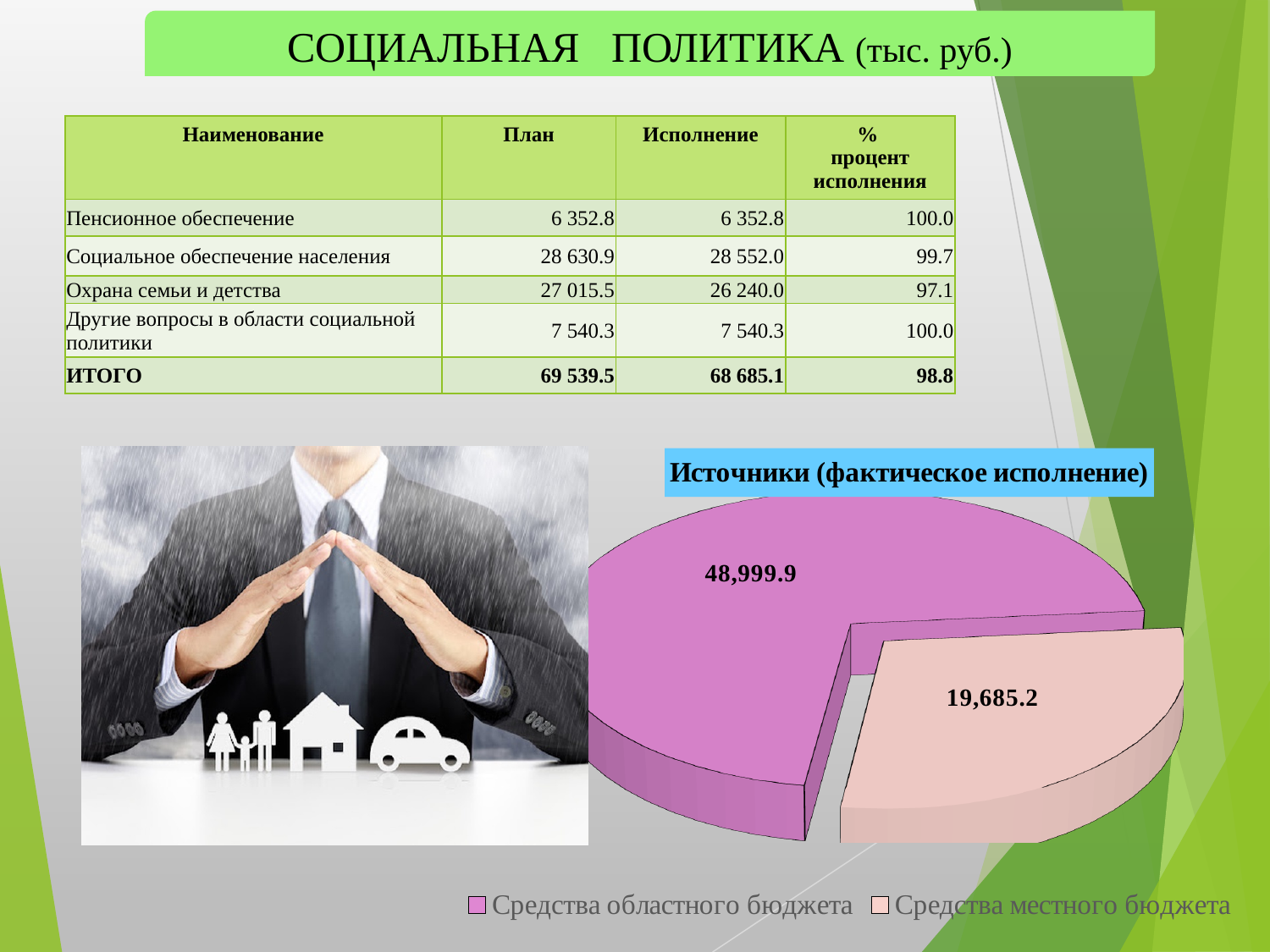
Which slice of the pie chart is the largest? Средства областного бюджета How many entries does the legend of the pie chart list? 2 What is the difference between the two slices of the pie chart (48,999.9 and 19,685.2)? 29,314.7 What kind of chart is shown under the title "Источники (фактическое исполнение)"? pie chart How many slices does the pie chart have? 2 Which slice of the pie chart is the smallest? Средства местного бюджета What is the title of the pie chart? Источники (фактическое исполнение) What share of the pie chart does "Средства областного бюджета" represent? 71.3% What is the value of the "Средства областного бюджета" slice in the pie chart? 48,999.9 What is the total of the two slices in the pie chart? 68,685.1 What is the value of the "Средства местного бюджета" slice in the pie chart? 19,685.2 In the pie chart, which is larger: "Средства областного бюджета" or "Средства местного бюджета"? Средства областного бюджета